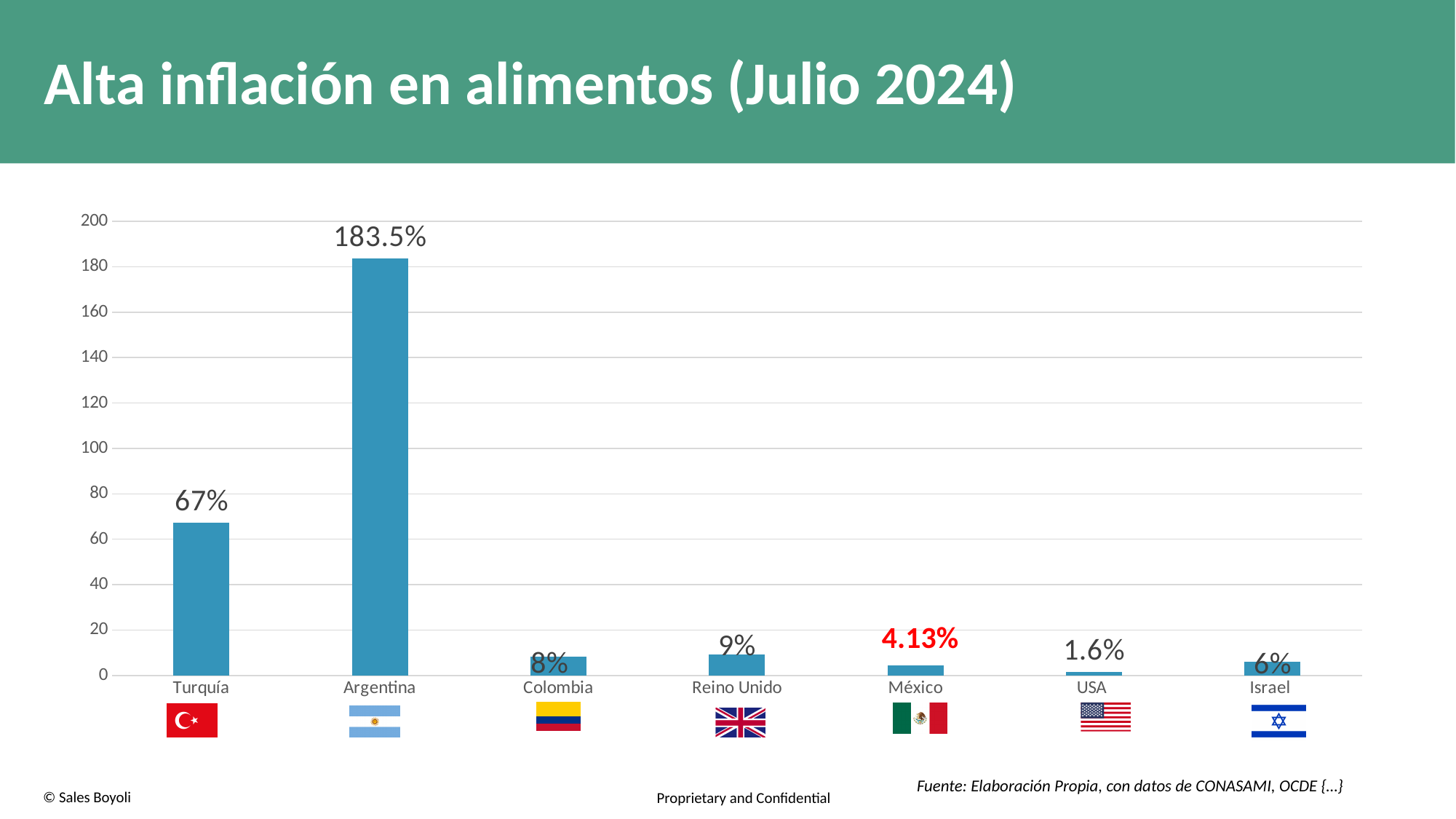
What is the food inflation value shown for Argentina? 183.5% What is the value shown for Turquía? 67% Is the value for Turquía greater or less than 60? greater How many countries are shown on the chart? 7 Which country has the highest value on the chart? Argentina What is the value shown for USA? 1.6% Which country has the lowest value on the chart? USA What is the value shown for México? 4.13% What is the title of the slide? Alta inflación en alimentos (Julio 2024) Which has a larger value, Reino Unido or Colombia? Reino Unido What is the difference between the values for Argentina and Turquía? 116.5% What kind of chart is shown on the slide? Bar chart